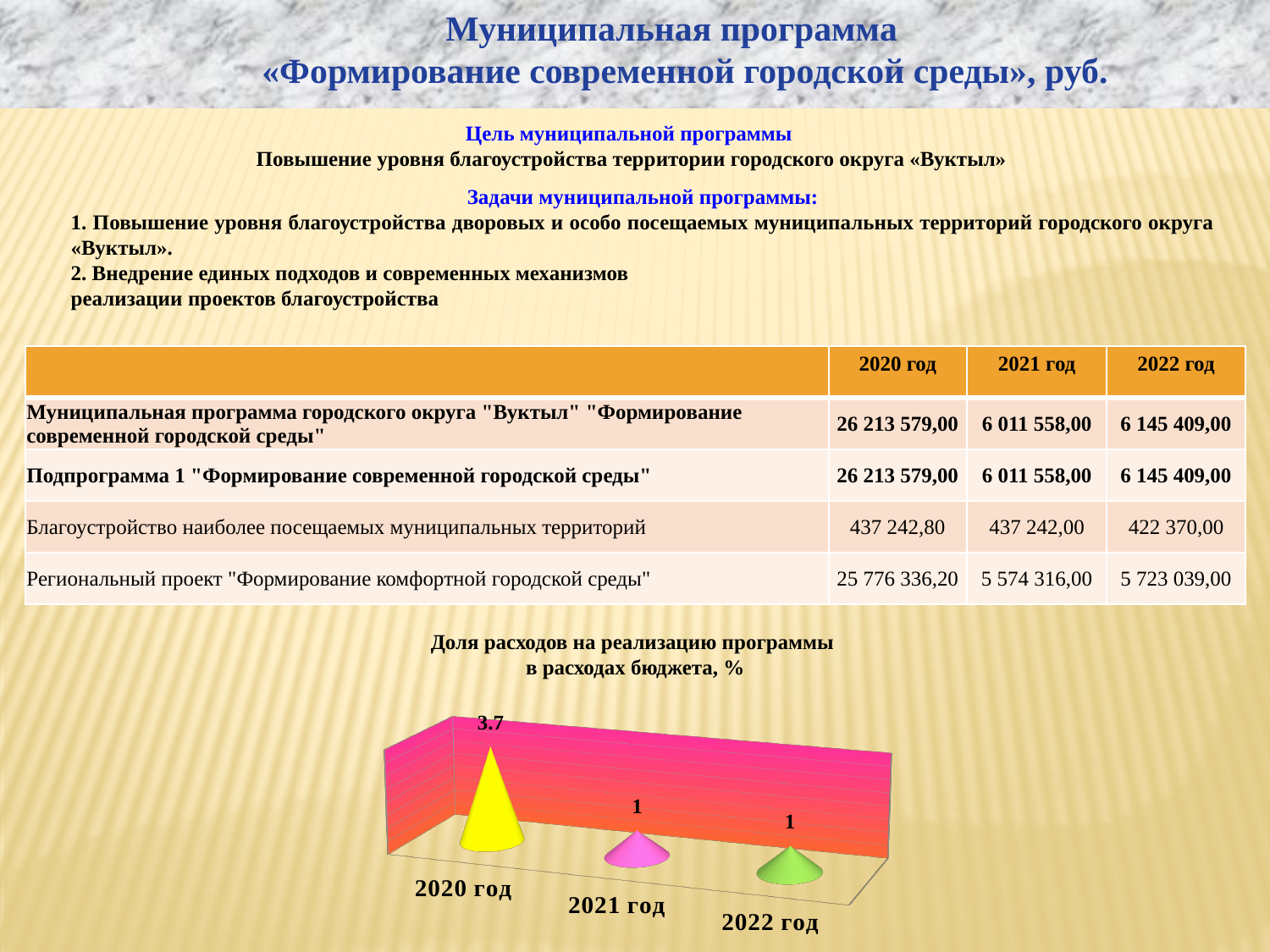
Which year has the highest value in the chart? 2020 год How many years are plotted in the chart? 3 Which is larger, the value for 2020 год or the value for 2022 год? 2020 год What is the title of the chart? Доля расходов на реализацию программы в расходах бюджета, % What kind of chart is shown on the slide? bar chart What is the value shown for 2021 год in the chart? 1 What is the difference between the values for 2020 год and 2021 год? 2.7 Does the value fall or rise from 2020 год to 2021 год? fall What colour is the cone for 2020 год? yellow What is the value shown for 2020 год in the chart? 3.7 What is the value shown for 2022 год in the chart? 1